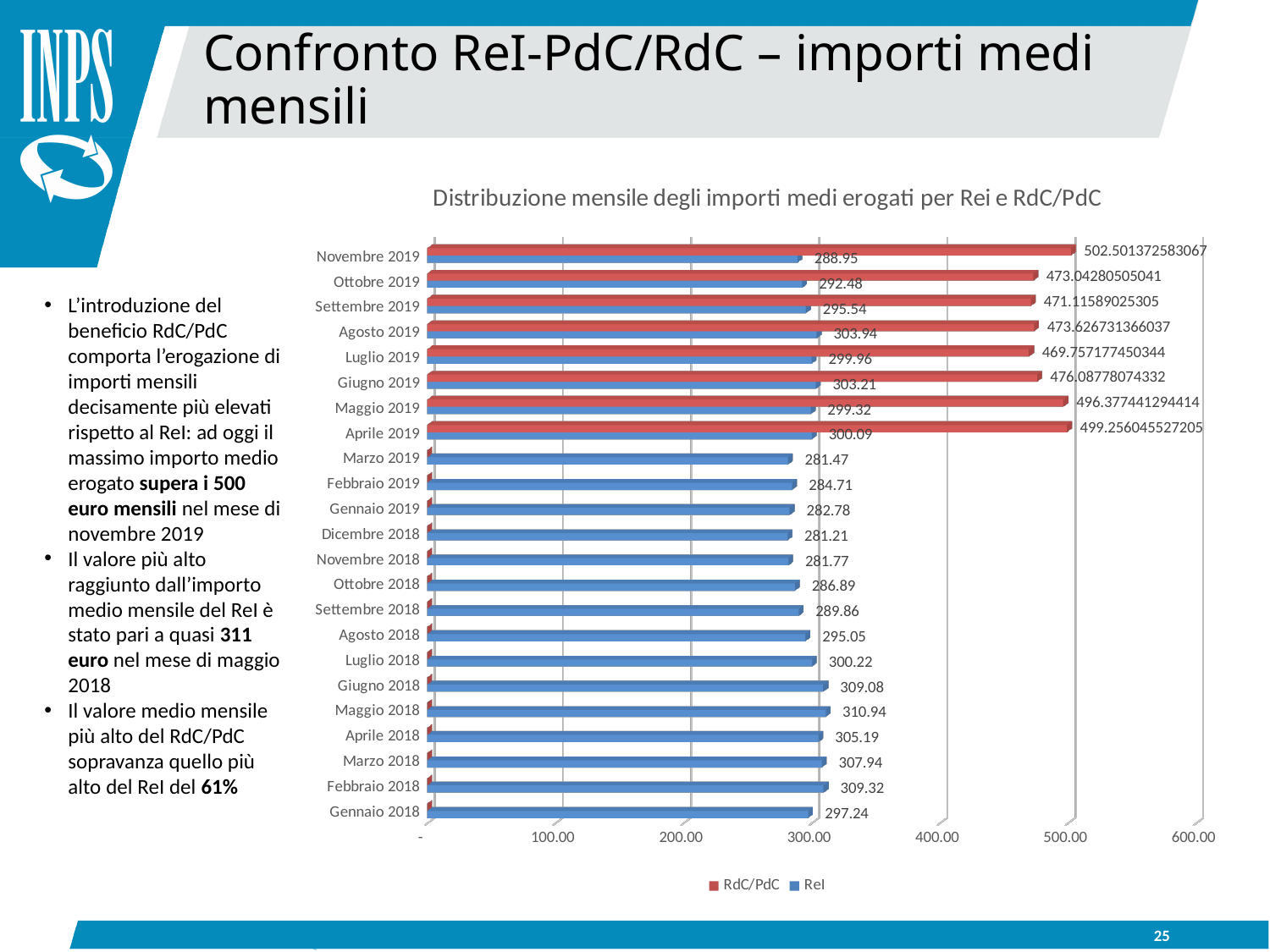
Which month has the highest ReI value? Maggio 2018 How many series does the legend list? 2 What is the ReI value for Novembre 2019? 288.95 What is the difference between the ReI values for Maggio 2018 and Gennaio 2018? 13.70 In Novembre 2019, which series has the larger value, RdC/PdC or ReI? RdC/PdC What kind of chart is shown on the slide? Bar chart What is the ReI value for Maggio 2018? 310.94 What is the ReI value for Gennaio 2018? 297.24 Is the RdC/PdC value for Novembre 2019 greater or less than 500.00? greater Which month has the lowest RdC/PdC value? Luglio 2019 How many months are shown on the vertical axis of the chart? 23 Which month has the highest RdC/PdC value? Novembre 2019